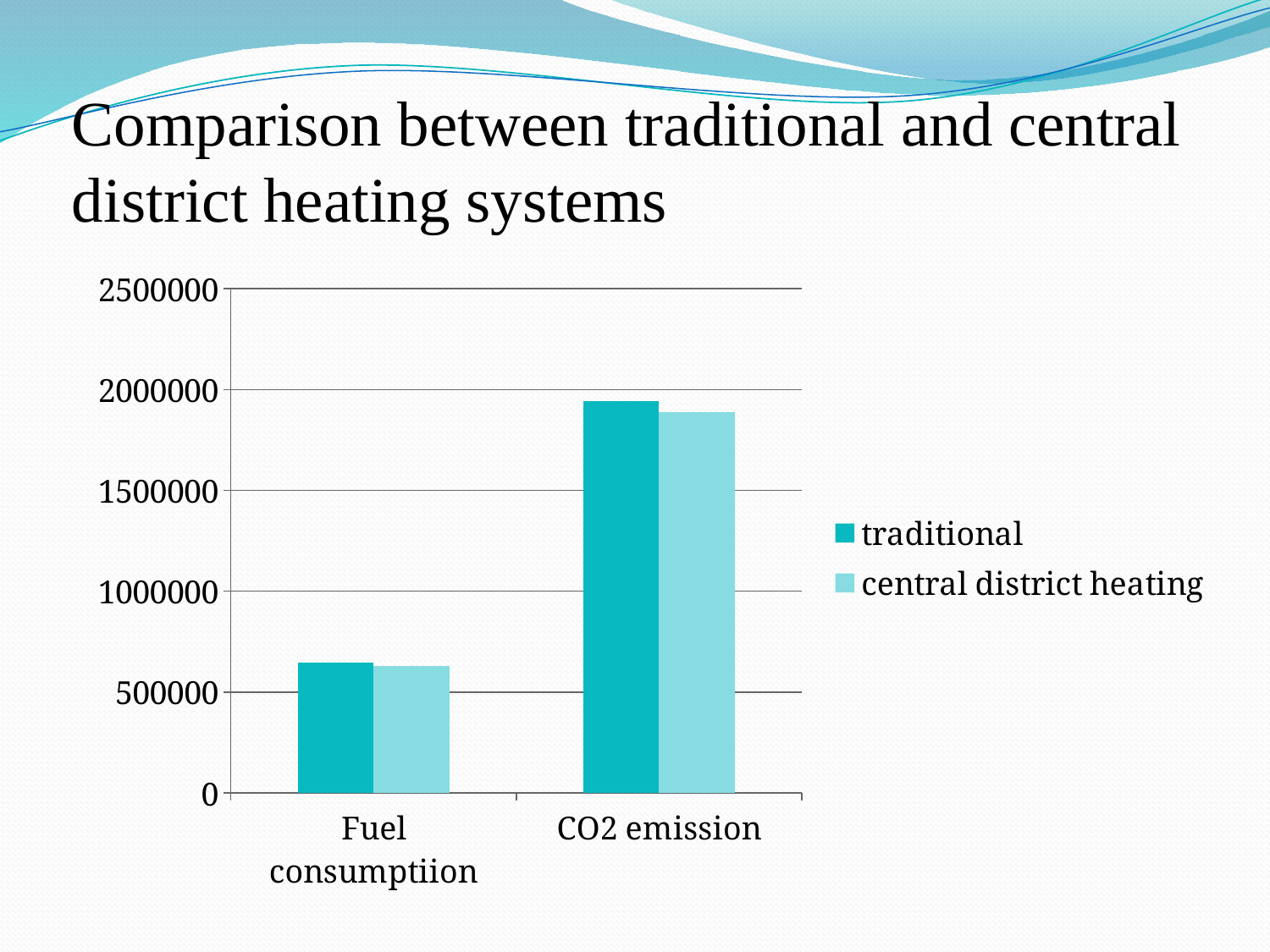
Which category has the lowest value for the central district heating series? Fuel consumptiion Is the traditional value for Fuel consumptiion greater or less than 500000? greater What kind of chart is shown on the slide? bar chart Which is larger: the traditional value for CO2 emission or the traditional value for Fuel consumptiion? CO2 emission For CO2 emission, which series has the larger value: traditional or central district heating? traditional How many series does the legend list? 2 Which category has the highest value for the traditional series? CO2 emission Is the central district heating value for CO2 emission greater or less than 1500000? greater How many categories are shown on the x axis? 2 What are the two series named in the legend? traditional and central district heating Is the traditional value for CO2 emission greater or less than 2000000? less